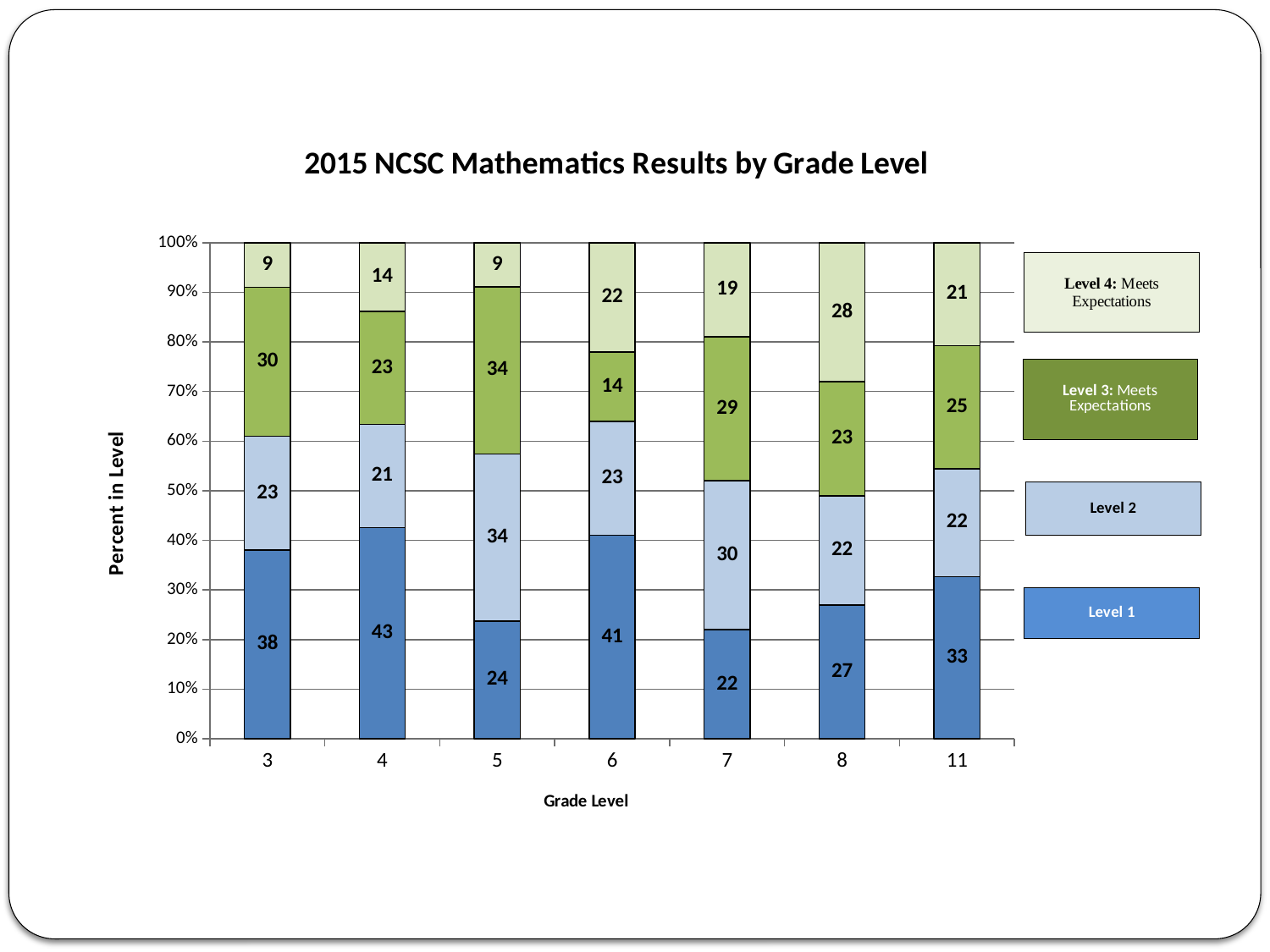
Which is larger, the Level 3 value for Grade 3 or the Level 3 value for Grade 6? Grade 3 What kind of chart is shown on the slide? Stacked bar chart Which grade level has the lowest Level 1 percentage? 7 What is the Level 3 value for Grade 5? 34 Which grade level has the highest Level 4 percentage? 8 How many grade levels are shown on the x axis? 7 What is the title of the chart? 2015 NCSC Mathematics Results by Grade Level What percentage of Grade 3 students scored at Level 1? 38 What is the difference between the Level 1 values for Grade 4 and Grade 5? 19 Which grade level has the highest Level 1 percentage? 4 What is the Level 4 value for Grade 8? 28 How many levels does the legend list? 4